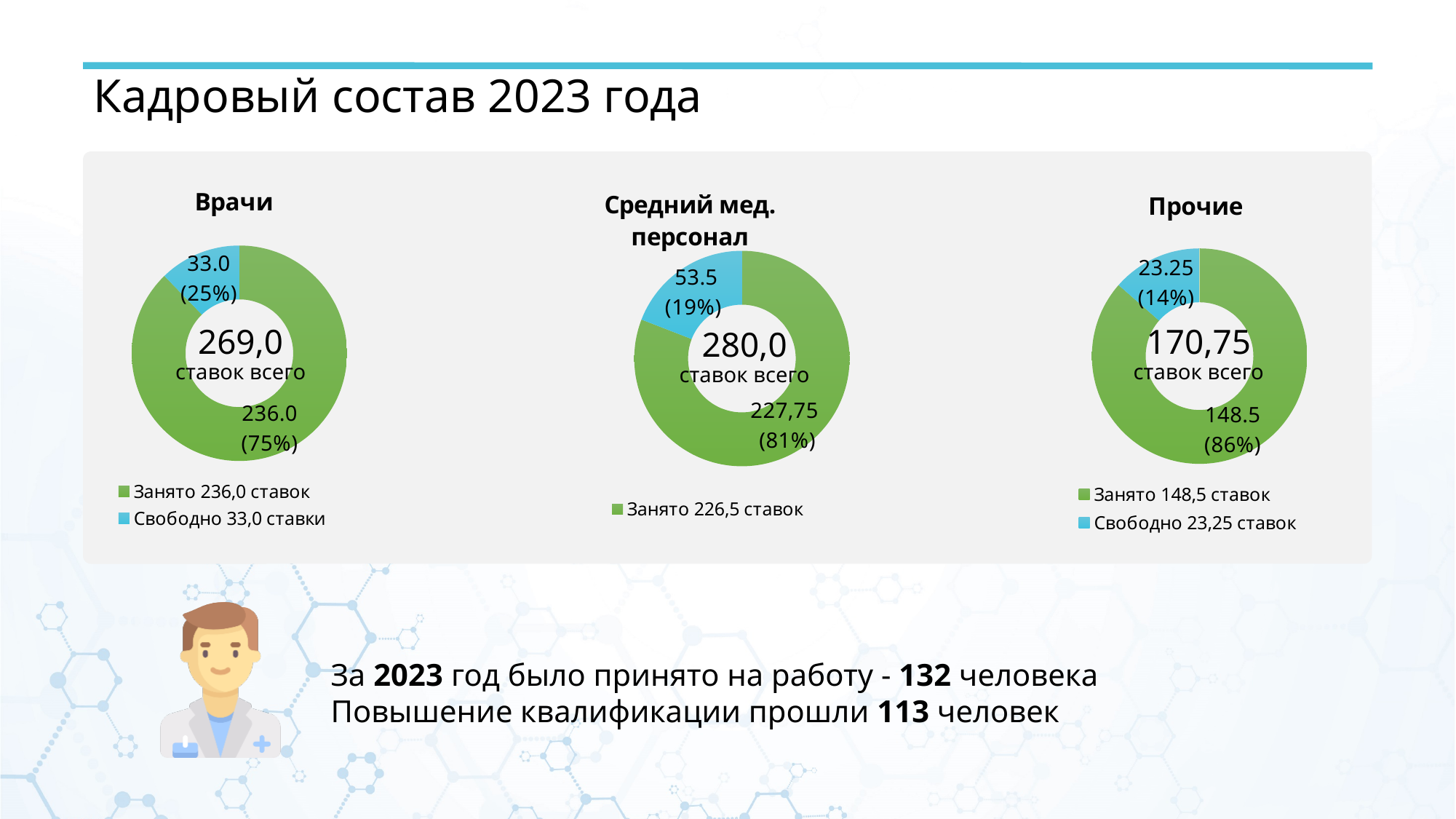
On the 'Прочие' chart, what share does the 'Свободно' segment represent? 14% What type of chart is used for 'Прочие'? Donut (pie) chart On the 'Врачи' chart, what share of the total does the 'Свободно' segment represent? 25% On the 'Врачи' chart, what is the difference between the занято value and the свободно value? 203.0 What total number of ставок is shown in the centre of the 'Прочие' chart? 170,75 On the 'Прочие' chart, what value is shown for the blue (свободно) segment? 23.25 What total number of ставок is shown in the centre of the 'Средний мед. персонал' chart? 280,0 On the 'Средний мед. персонал' chart, what value is shown for the blue (свободно) segment? 53.5 How many segments does the 'Прочие' chart have? 2 On the 'Врачи' chart, what value is shown for the green (занято) segment? 236.0 On the 'Врачи' chart, which segment is larger, занято or свободно? занято On the 'Средний мед. персонал' chart, what share does the green (занято) segment represent? 81%